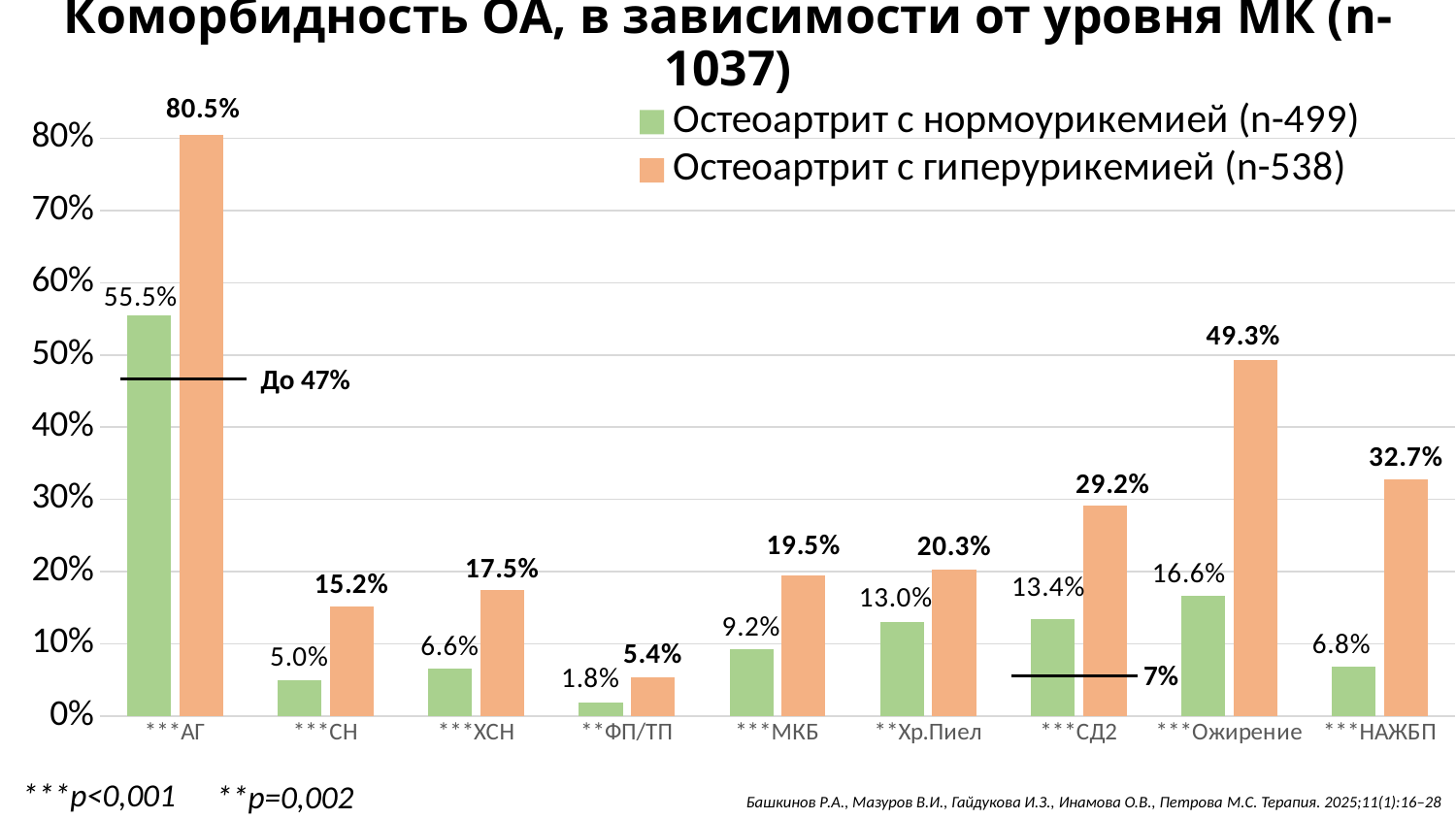
What is the difference between the two series for АГ? 25.0% How many categories are shown on the x axis? 9 What is the value for НАЖБП in the series 'Остеоартрит с гиперурикемией (n-538)'? 32.7% What is the value for АГ in the series 'Остеоартрит с гиперурикемией (n-538)'? 80.5% What colour represents the series 'Остеоартрит с гиперурикемией (n-538)'? orange Which is larger for Хр.Пиел: the value for 'Остеоартрит с нормоурикемией (n-499)' or for 'Остеоартрит с гиперурикемией (n-538)'? Остеоартрит с гиперурикемией (n-538) How many series does the legend list? 2 What is the value for Ожирение in the series 'Остеоартрит с нормоурикемией (n-499)'? 16.6% Which category has the highest value in the series 'Остеоартрит с гиперурикемией (n-538)'? АГ Which category has the lowest value in the series 'Остеоартрит с нормоурикемией (n-499)'? ФП/ТП What kind of chart is shown on the slide? bar chart What is the difference between the two series for СД2? 15.8%